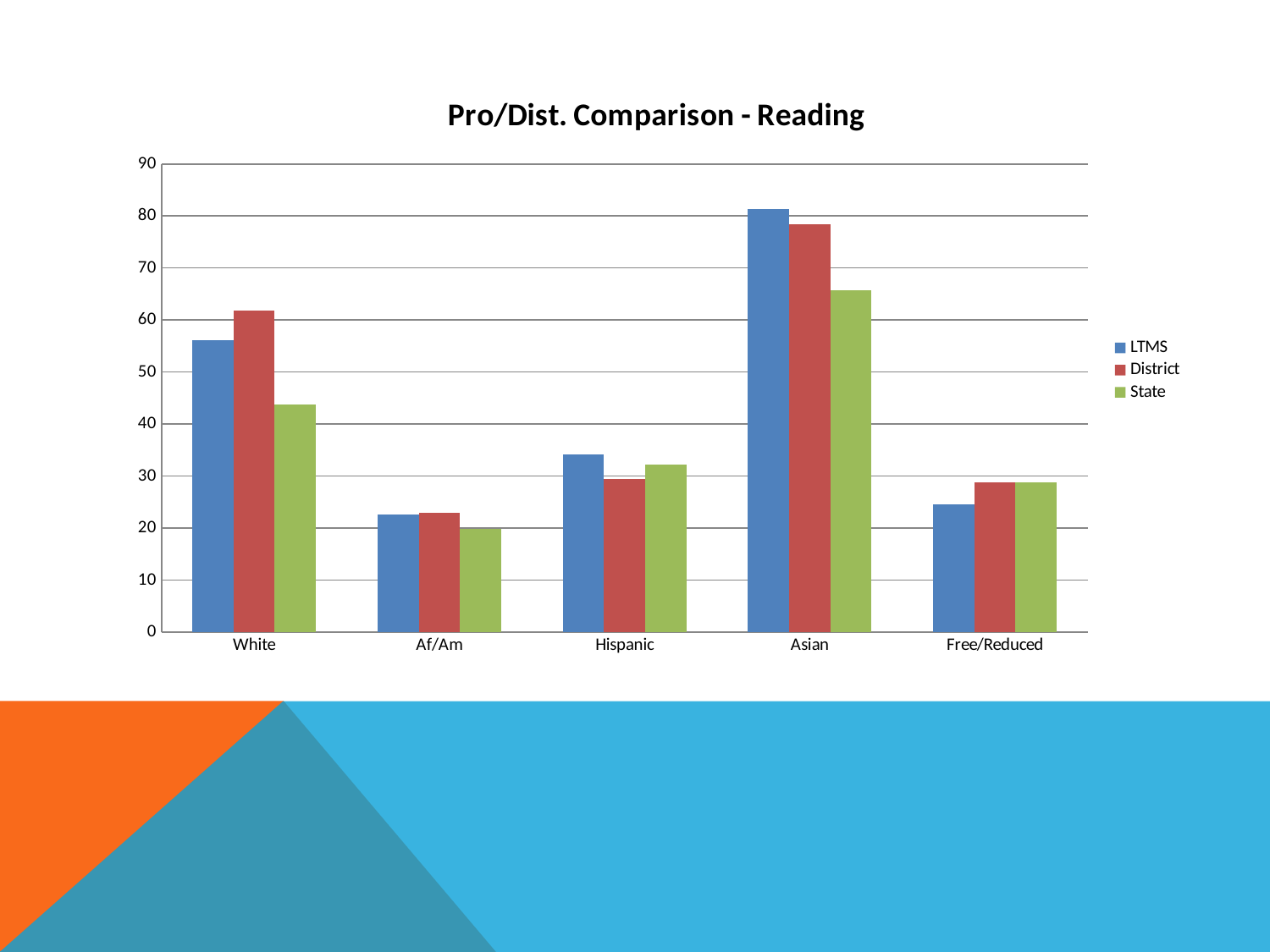
For the Asian category, which is larger: the LTMS value or the State value? LTMS Is the LTMS value for Free/Reduced greater or less than 30? less For the White category, which is larger: the LTMS value or the District value? District What type of chart is shown on the slide? bar chart What is the title of the chart? Pro/Dist. Comparison - Reading Is the State value for White greater or less than 50? less How many categories are shown on the x axis? 5 Is the LTMS value for Asian greater or less than 70? greater How many series does the legend list? 3 Which category has the highest LTMS value? Asian Which category has the lowest State value? Af/Am